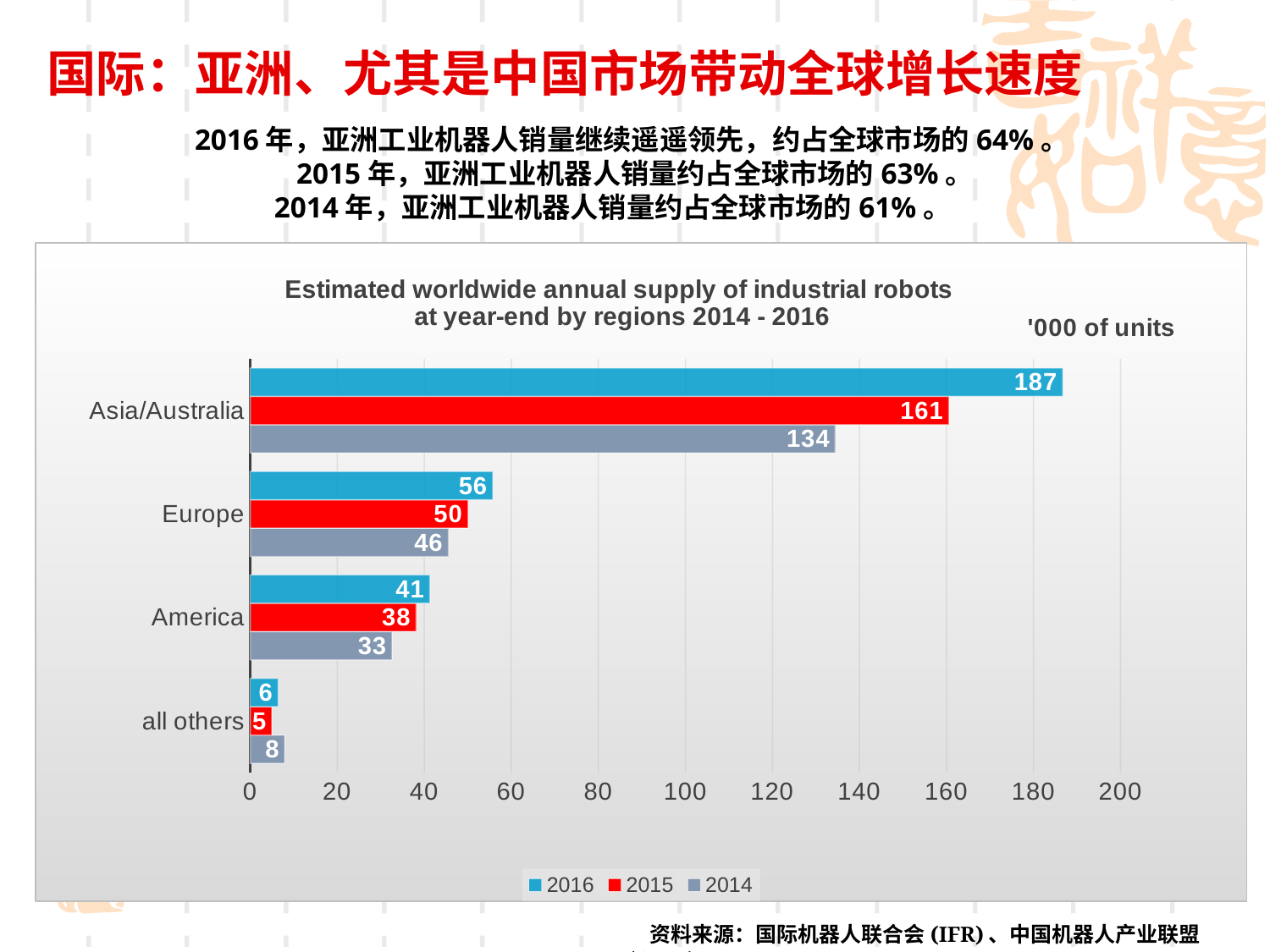
How many regions are shown on the chart? 4 What is the 2015 value for America? 38 What is the difference between the 2016 and 2014 values for Asia/Australia? 53 What unit is stated for the values on the chart? '000 of units What is the 2016 value for Asia/Australia? 187 How many series does the legend list? 3 Is the 2015 value for Asia/Australia greater or less than 140? greater Which is larger for all others: the 2016 value or the 2014 value? 2014 Which region has the lowest 2015 value? all others What is the 2014 value for Europe? 46 What kind of chart is shown? bar chart Which region has the highest 2016 value? Asia/Australia